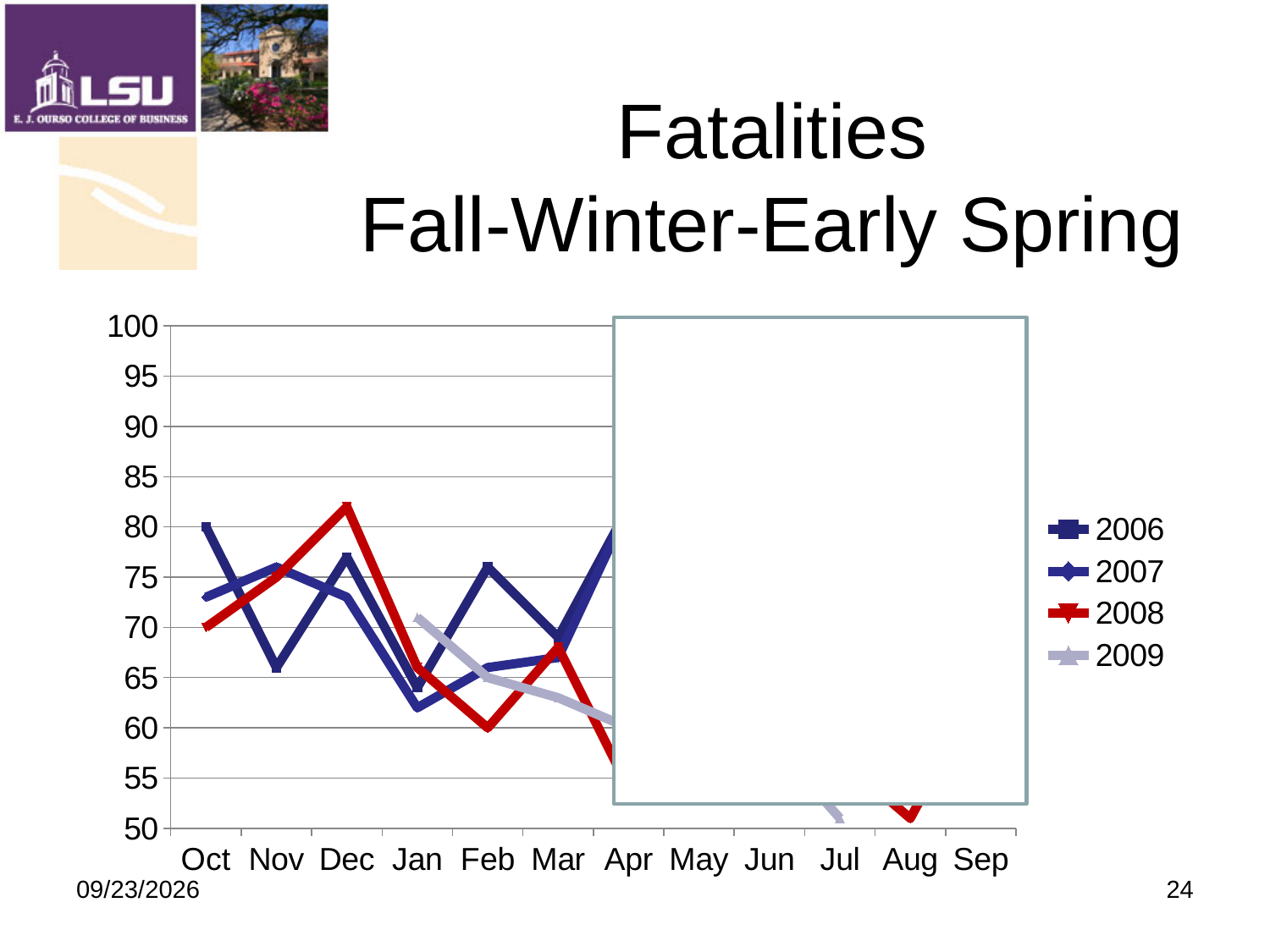
What kind of chart is shown on the slide? line chart Is the 2008 value for Dec greater or less than 80? greater Is the 2006 value for Oct greater or less than 75? greater What is the title of the chart? Fatalities Fall-Winter-Early Spring Which series has the lowest value in Feb? 2008 Is the 2008 value for Feb greater or less than 65? less How many months are labelled on the x axis? 12 How many series does the legend list? 4 What colour is the line for the 2008 series? red Which series has the highest value in Dec? 2008